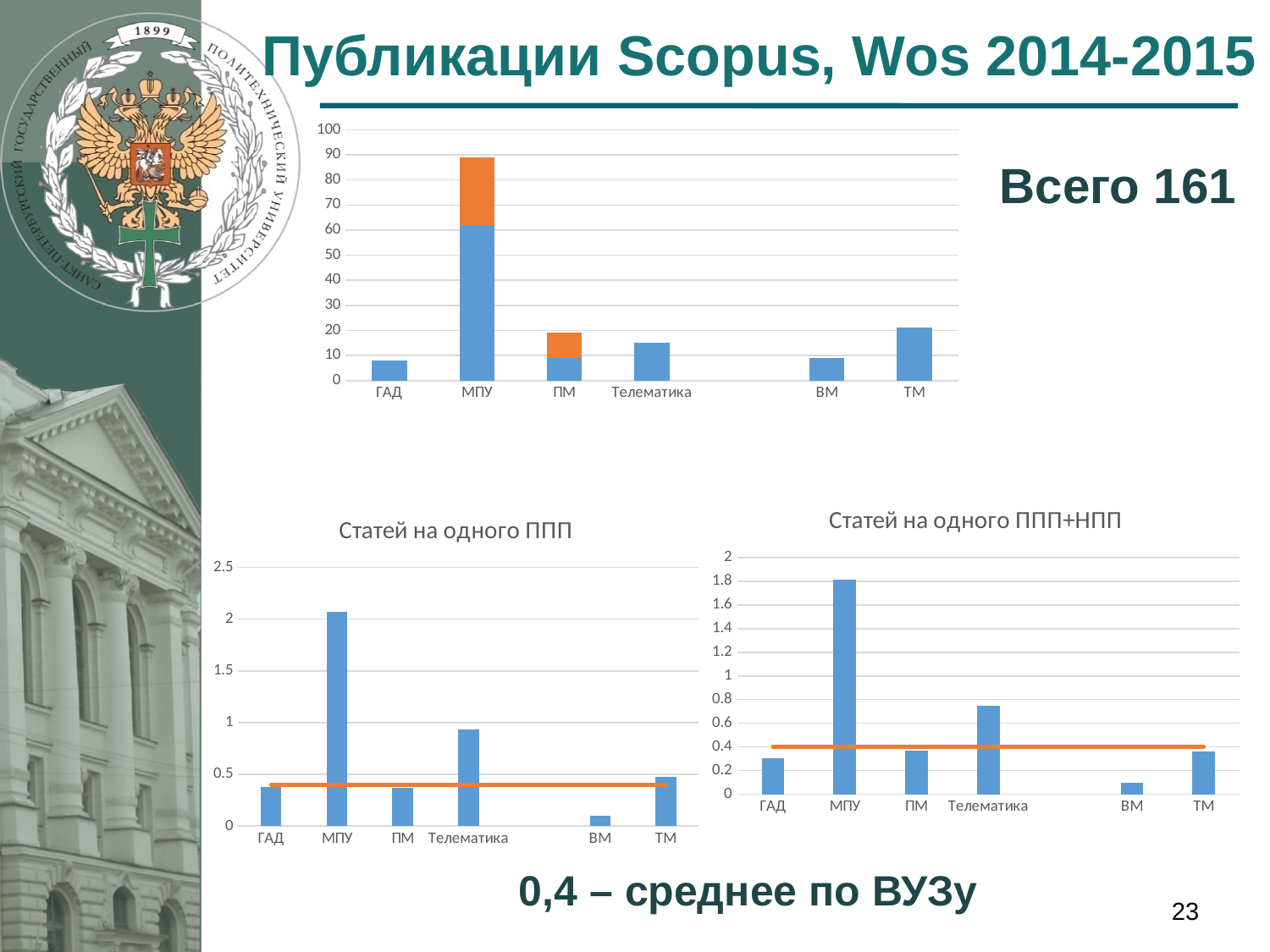
In the chart titled 'Статей на одного ППП+НПП', which category has the lowest value? ВМ In the top chart, is the total value for МПУ greater or less than 80? greater In the chart titled 'Статей на одного ППП+НПП', is the value for Телематика greater or less than 0.6? greater In the top chart, which category has the tallest bar? МПУ In the top chart, which is larger, the bar for ТМ or the bar for Телематика? ТМ In the chart titled 'Статей на одного ППП+НПП', which category has the highest value? МПУ In the chart titled 'Статей на одного ППП', which category has the highest value? МПУ How many labeled categories are shown on the x axis of the chart titled 'Статей на одного ППП+НПП'? 6 In the chart titled 'Статей на одного ППП', which category has the lowest value? ВМ In the chart titled 'Статей на одного ППП', is the value for Телематика greater or less than 1? less What kind of chart is the top chart on the slide? bar chart